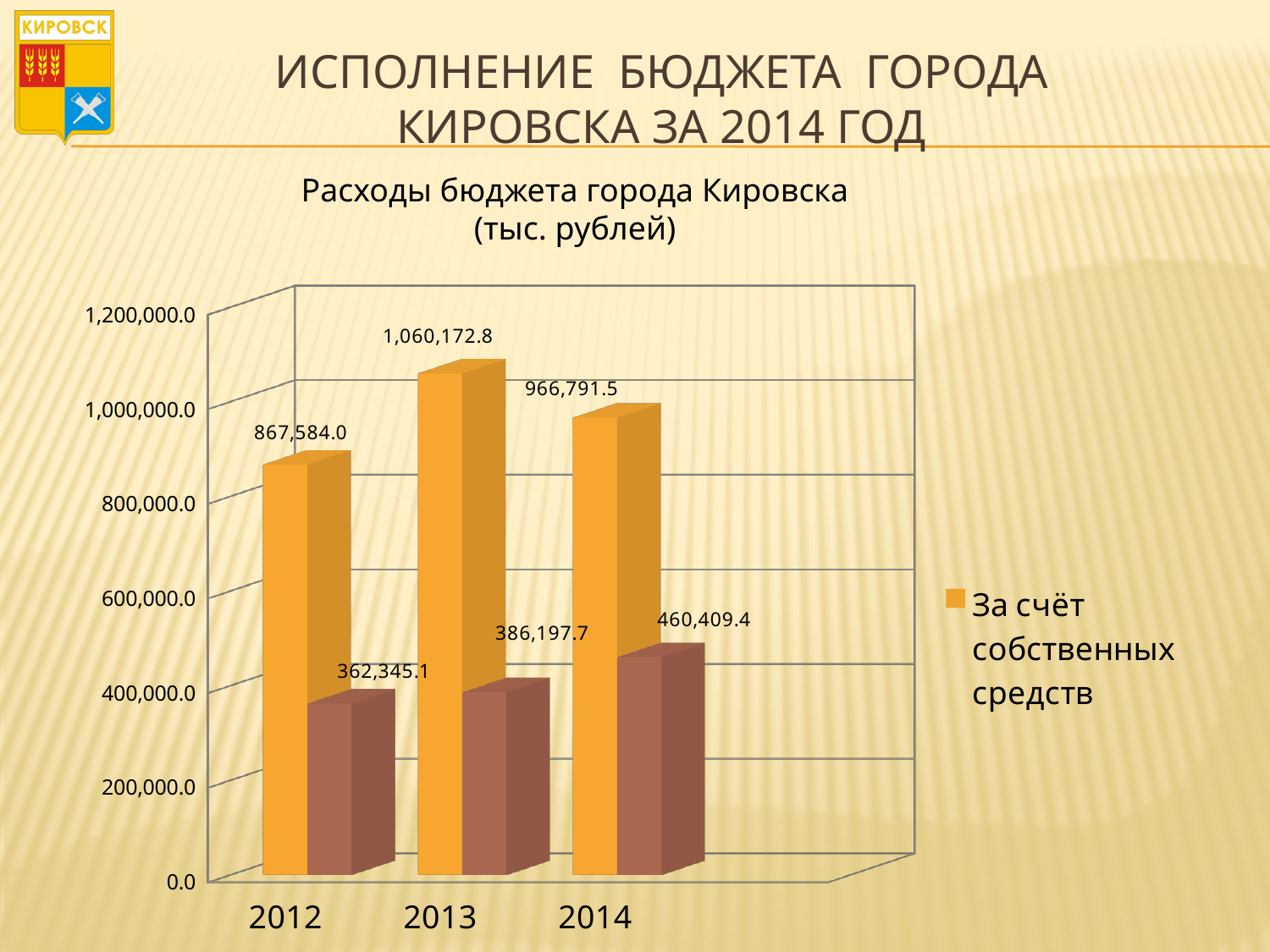
What is the value of the brown bar for 2014? 460,409.4 What kind of chart is shown on the slide? bar chart Which year has the highest orange bar? 2013 Which year has the lowest brown bar? 2012 What is the value of the brown bar for 2013? 386,197.7 How many years are shown on the x axis? 3 What is the difference between the orange bar values for 2013 and 2014? 93,381.3 Is the value of the orange bar for 2014 greater or less than 1,000,000.0? less What is the value of the orange bar for 2012? 867,584.0 Which is larger: the brown bar for 2014 or the brown bar for 2013? 2014 What is the value of the orange bar for 2013? 1,060,172.8 What is the title of the chart? Расходы бюджета города Кировска (тыс. рублей)